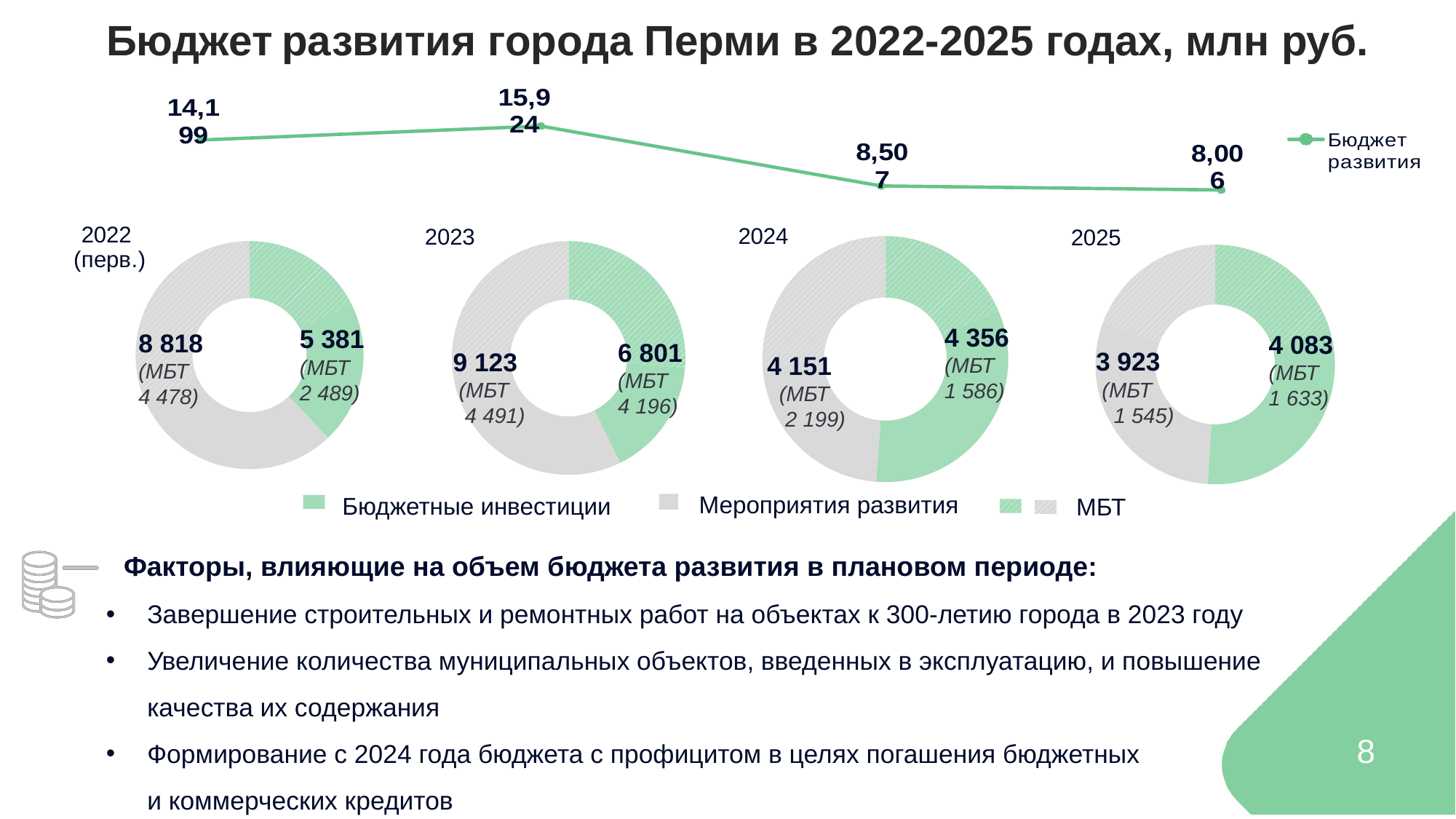
On the top line chart 'Бюджет развития', which year has the lowest value? 2025 On the 2023 donut chart, what is the difference between Мероприятия развития and Бюджетные инвестиции? 2 322 On the top line chart 'Бюджет развития', what is the value for 2023? 15,924 On the 2023 donut chart, what is the value for Мероприятия развития? 9 123 On the top line chart 'Бюджет развития', which year has the highest value? 2023 On the 2022 (перв.) donut chart, what is the МБТ amount within Мероприятия развития? 4 478 On the 2025 donut chart, which is larger: Бюджетные инвестиции or Мероприятия развития? Бюджетные инвестиции On the top line chart 'Бюджет развития', do the values rise or fall from 2023 to 2025? fall How many entries does the legend below the donut charts list? 3 What kind of chart is the top chart 'Бюджет развития'? line chart On the 2022 (перв.) donut chart, what is the value for Бюджетные инвестиции? 5 381 On the 2024 donut chart, what is the МБТ amount within Бюджетные инвестиции? 1 586